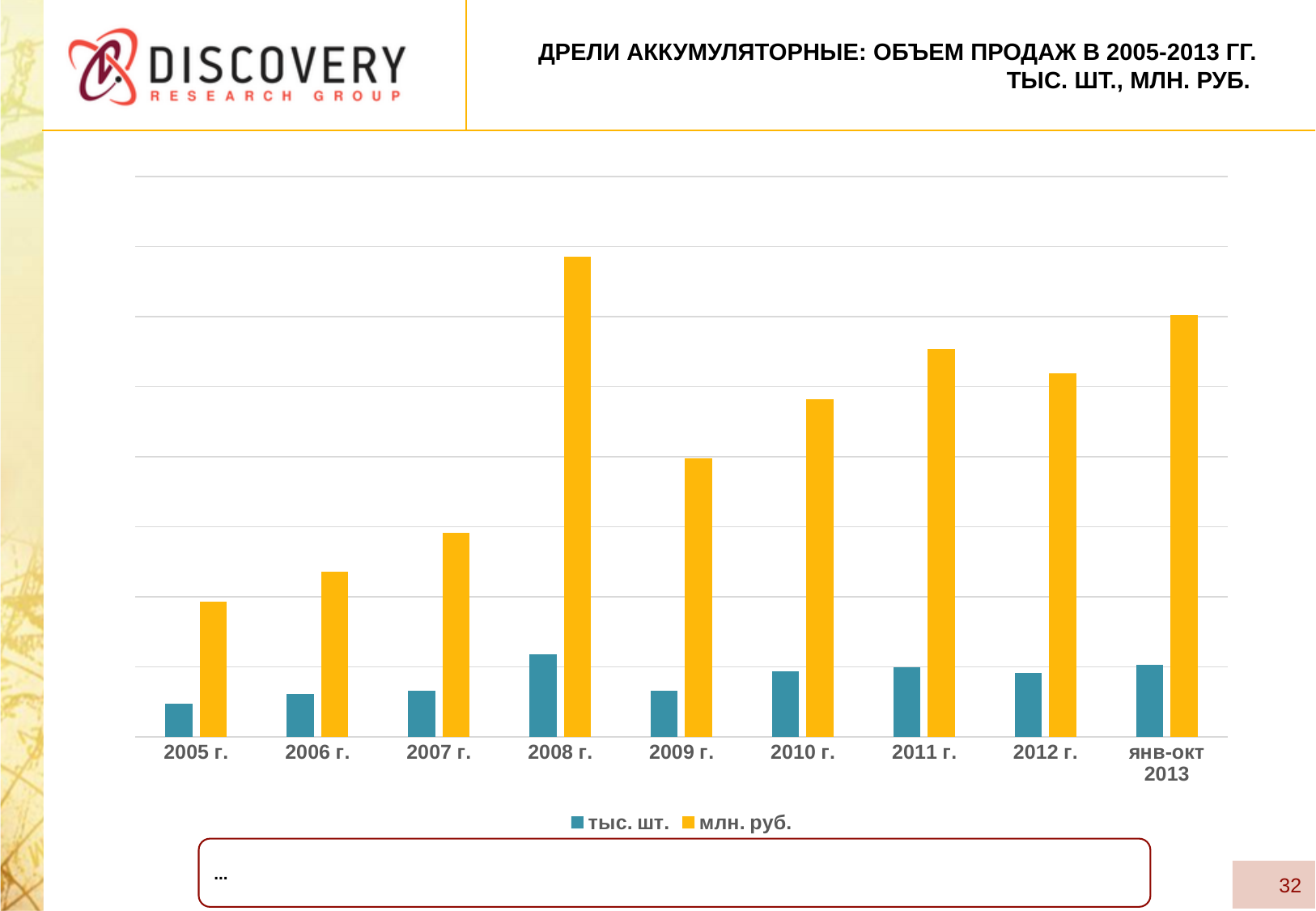
Which is larger for млн. руб.: 2011 г. or 2012 г.? 2011 г. In which year is the млн. руб. value lowest? 2005 г. In which year is the млн. руб. value highest? 2008 г. Do the млн. руб. values rise or fall from 2005 г. to 2008 г.? rise In which year is the тыс. шт. value lowest? 2005 г. Which is larger for млн. руб.: 2009 г. or 2010 г.? 2010 г. How many series does the legend list? 2 Which series is shown in yellow in the legend? млн. руб. What kind of chart is shown on the slide? bar chart How many categories are shown along the x axis? 9 Which is larger for тыс. шт.: 2008 г. or 2009 г.? 2008 г.